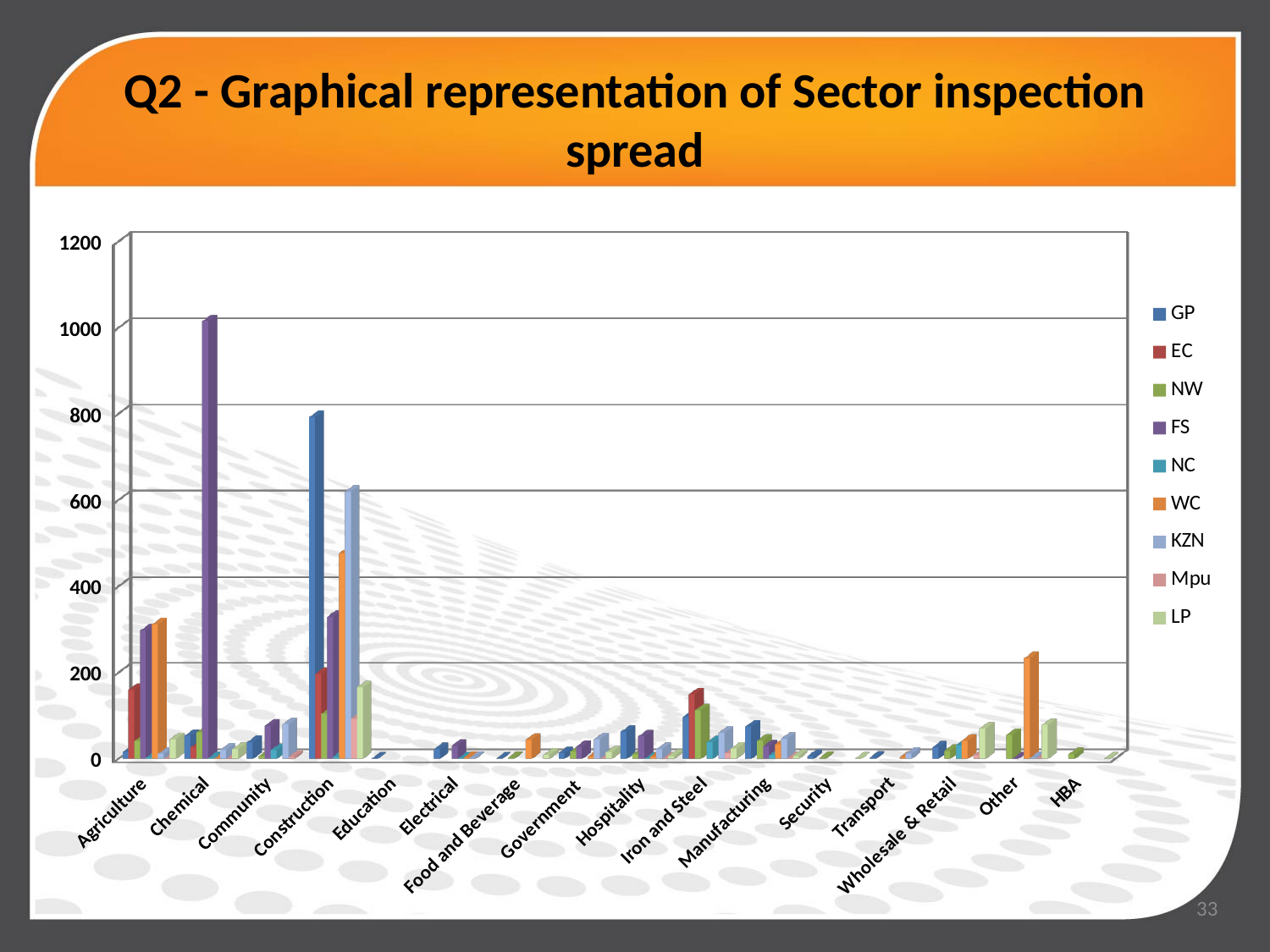
How many sector categories are shown on the x axis? 16 Which series has the highest value in the Construction sector? GP Which series has the highest value in the Other sector? WC Is the value for WC in the Other sector greater or less than 400? less Which is larger: the GP value in Construction or the KZN value in Construction? GP value in Construction What kind of chart is shown on the slide? Bar chart Which series has the highest value in the Chemical sector? FS Is the value for FS in the Chemical sector greater or less than 800? greater How many series does the legend list? 9 What is the title of the slide containing the chart? Q2 - Graphical representation of Sector inspection spread Is the value for GP in the Construction sector greater or less than 600? greater